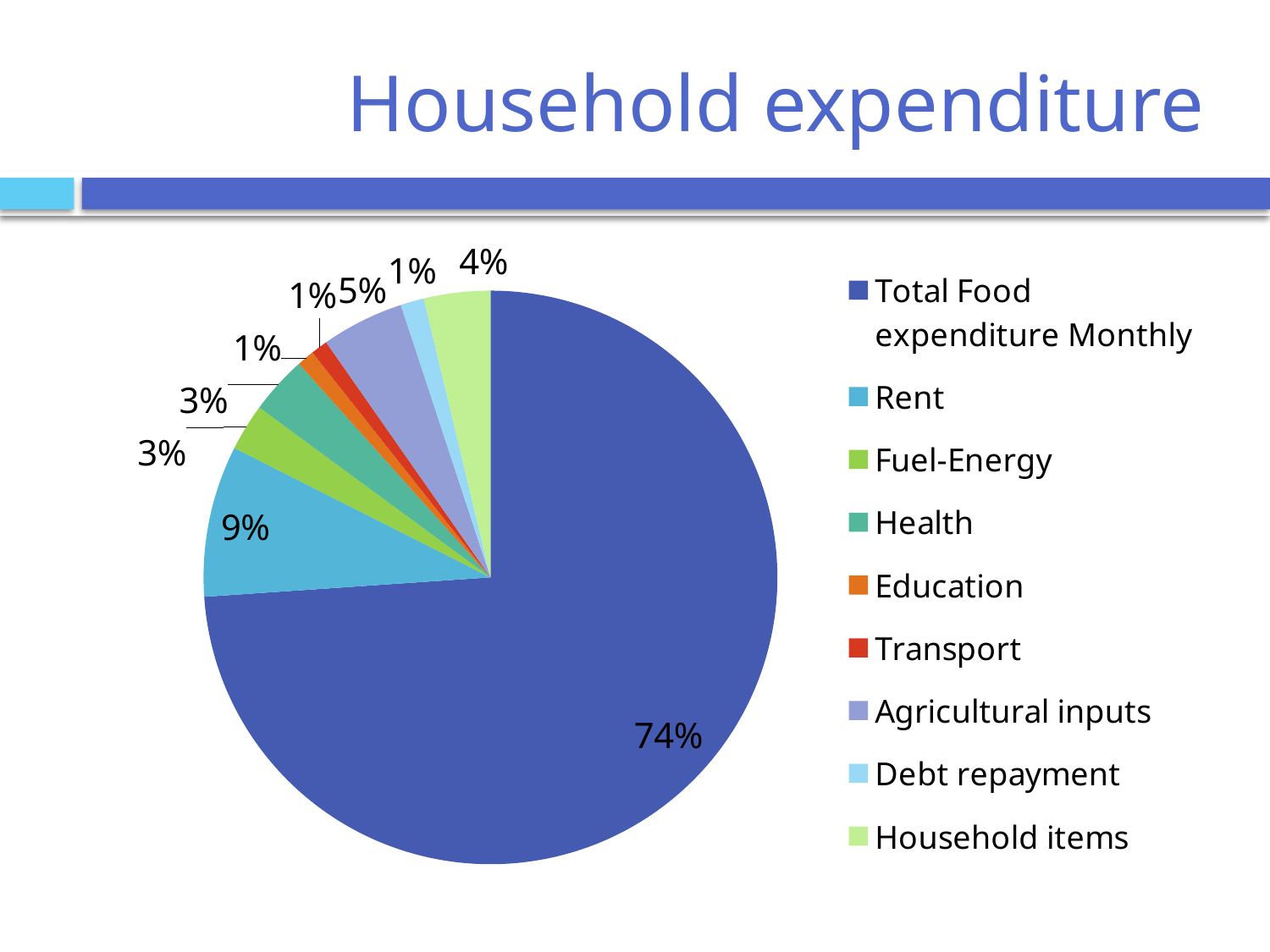
What is the difference in percentage points between Total Food expenditure Monthly and Rent? 65 What colour is the Transport slice in the pie chart? Red What share of household expenditure goes to Total Food expenditure Monthly? 74% What percentage is shown for Household items? 4% How many categories does the legend list? 9 Which category has the largest share of household expenditure? Total Food expenditure Monthly What share does Agricultural inputs take in the pie chart? 5% What kind of chart is shown on the slide? Pie chart What is the title of the slide? Household expenditure Which is larger, the share for Rent or the share for Agricultural inputs? Rent What share of expenditure is Fuel-Energy? 3% What percentage of household expenditure is Rent? 9%